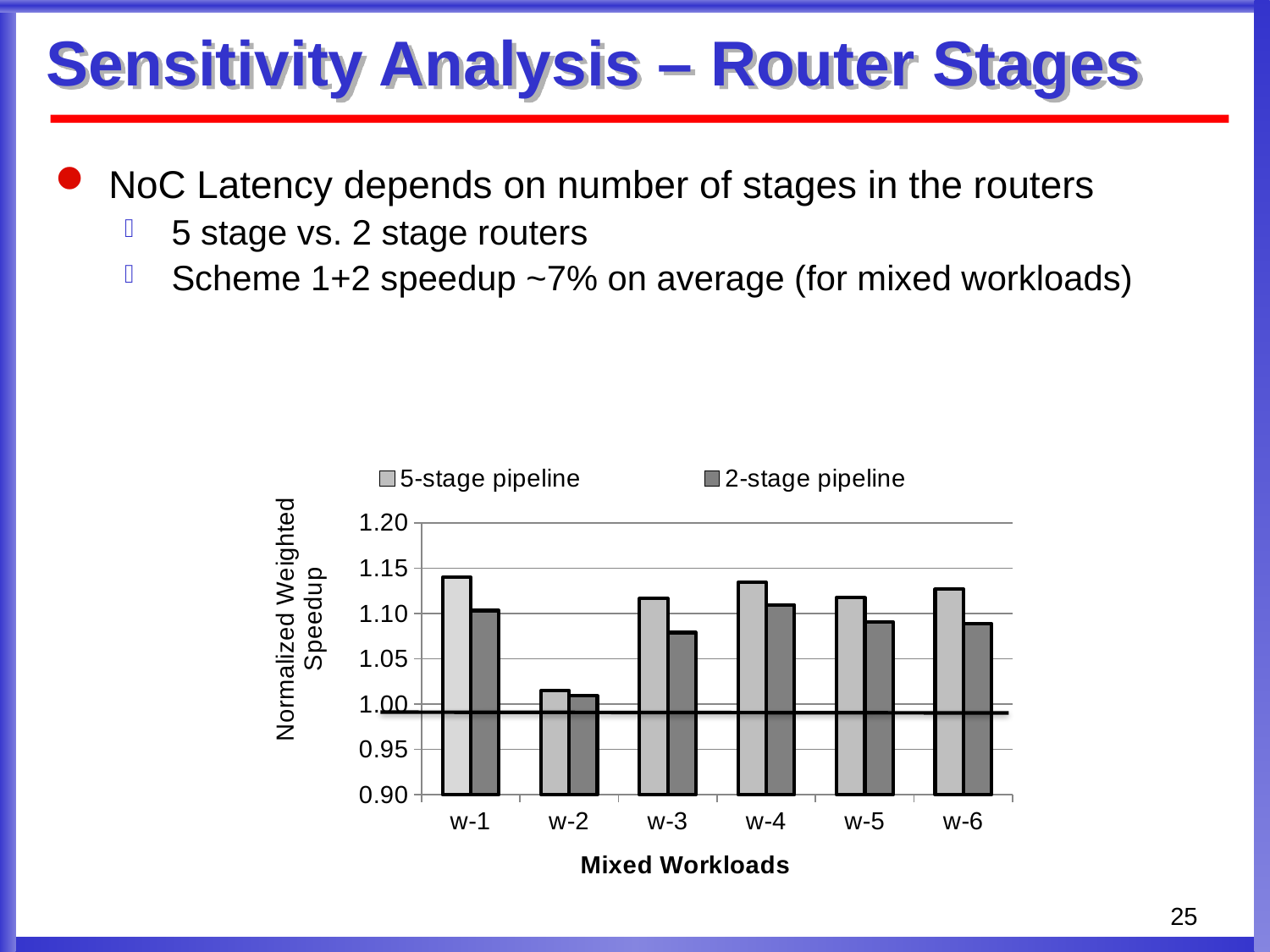
Is the 5-stage pipeline value for w-2 greater or less than 1.05? less For w-1, which is larger: the 5-stage pipeline value or the 2-stage pipeline value? 5-stage pipeline Which workload has the lowest 2-stage pipeline value? w-2 Is the 5-stage pipeline value for w-1 greater or less than 1.10? greater Is the 2-stage pipeline value for w-4 greater or less than 1.05? greater What kind of chart is shown on the slide? bar chart How many series does the chart legend list? 2 What is the title of the chart's y axis? Normalized Weighted Speedup How many mixed workloads are shown on the x axis of the chart? 6 Which is larger: the 5-stage pipeline value for w-3 or the 5-stage pipeline value for w-2? w-3 Which workload has the lowest 5-stage pipeline value? w-2